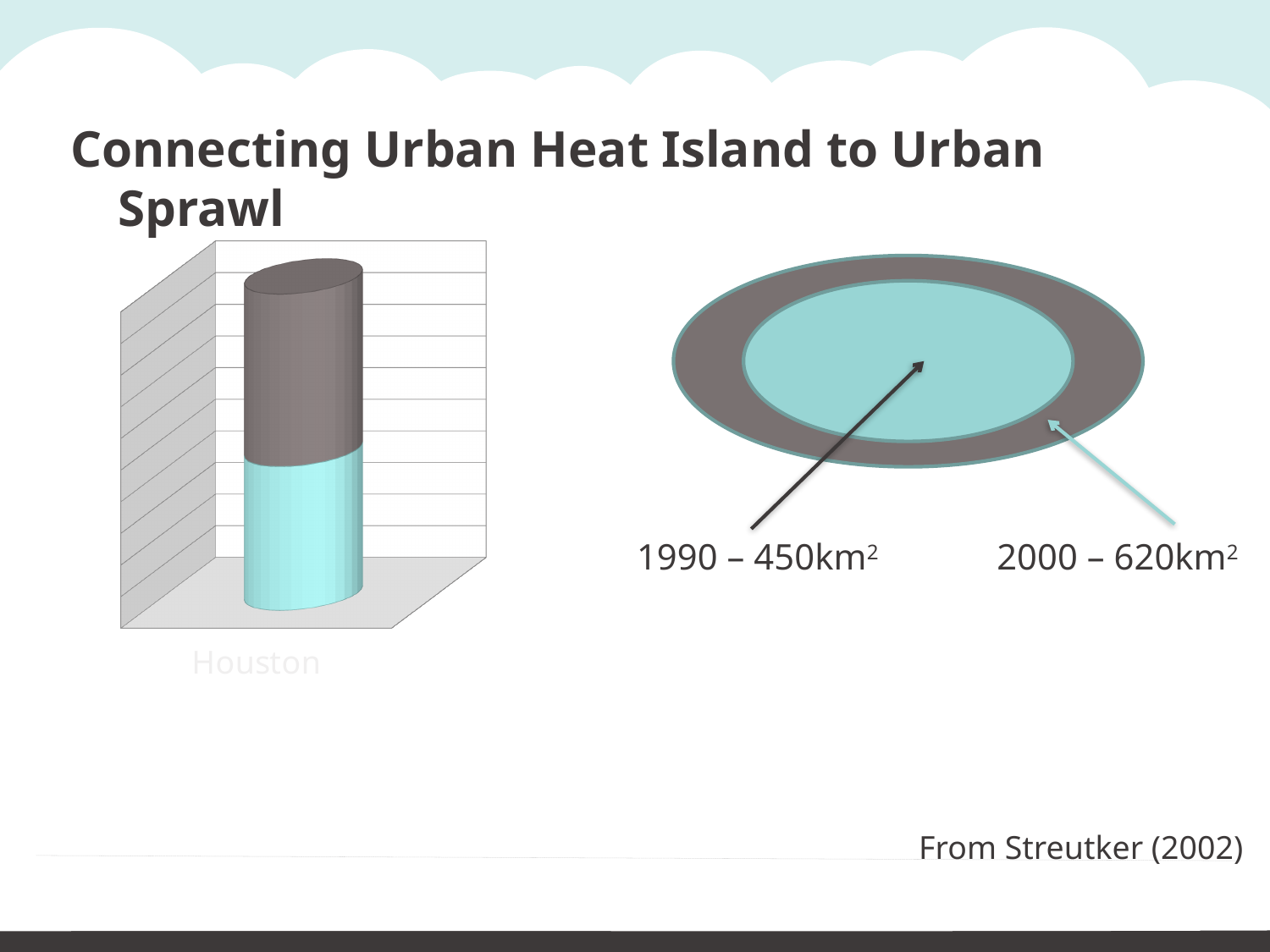
How many stacked segments make up the Houston bar in the chart on the left? 2 In the diagram on the right, which year has the larger area, 1990 or 2000? 2000 In the diagram on the right, what area is given for 1990? 450km2 What kind of chart is shown on the left of the slide? bar chart In the diagram on the right, by how much did the area grow from 1990 to 2000? 170km2 In the bar chart on the left, what colour is the bottom segment of the Houston bar? light blue What is the category label under the bar in the chart on the left? Houston How many categories does the bar chart on the left show? 1 In the diagram on the right, which year is represented by the inner ellipse? 1990 In the diagram on the right, what area is given for 2000? 620km2